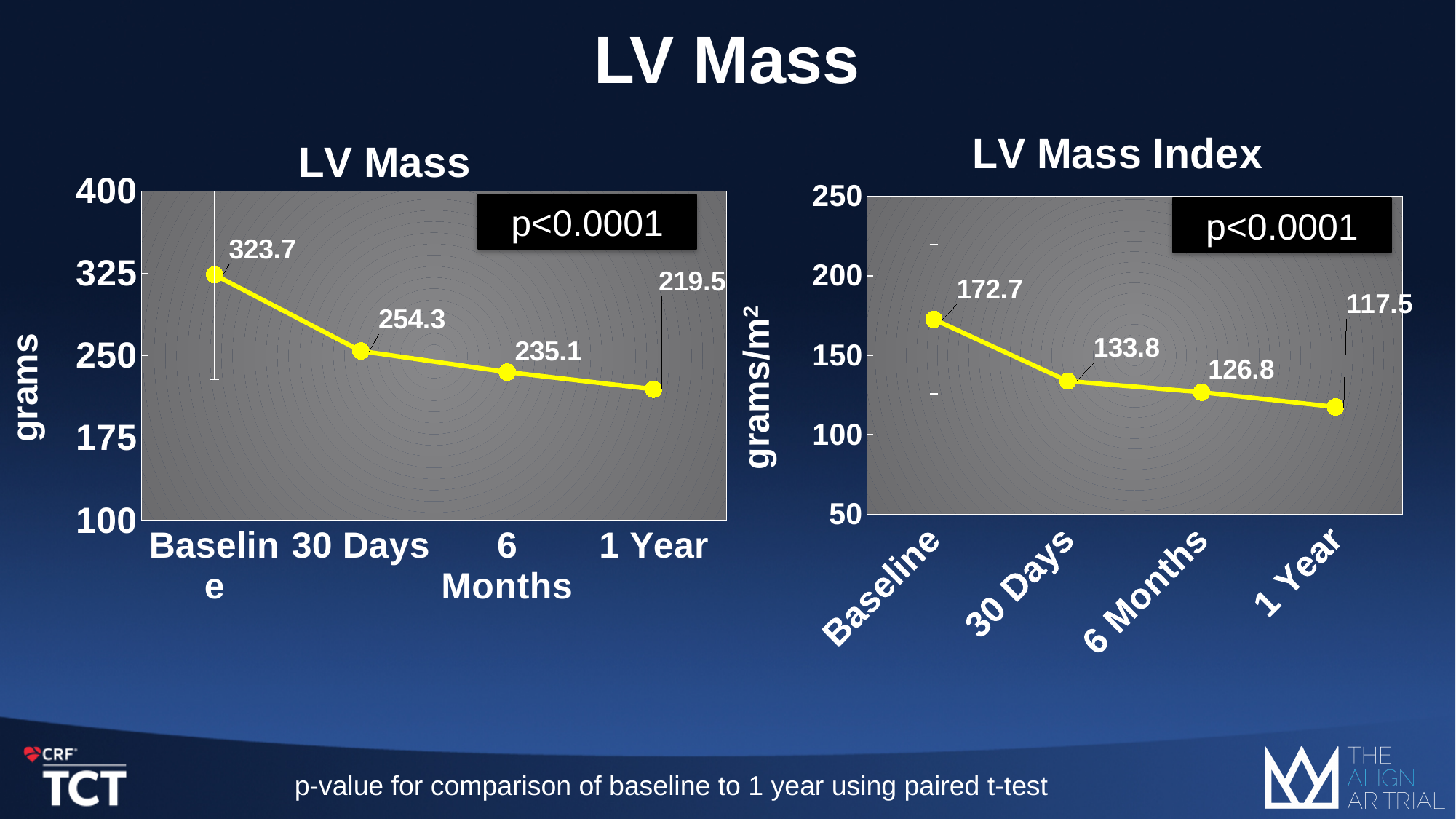
In the LV Mass Index chart, do the values rise or fall from Baseline to 1 Year? Fall In the LV Mass chart, what is the value at 1 Year? 219.5 What kind of chart is the LV Mass chart? Line chart In the LV Mass Index chart, what is the difference between the Baseline value and the 30 Days value? 38.9 In the LV Mass chart, which is larger, the value at 30 Days or the value at 6 Months? 30 Days How many time points are plotted in the LV Mass Index chart? 4 In the LV Mass chart, what is the value at Baseline? 323.7 In the LV Mass Index chart, which time point has the lowest value? 1 Year In the LV Mass chart, which time point has the highest value? Baseline In the LV Mass Index chart, what is the value at 30 Days? 133.8 In the LV Mass Index chart, what is the value at 6 Months? 126.8 In the LV Mass chart, what is the difference between the Baseline value and the 1 Year value? 104.2